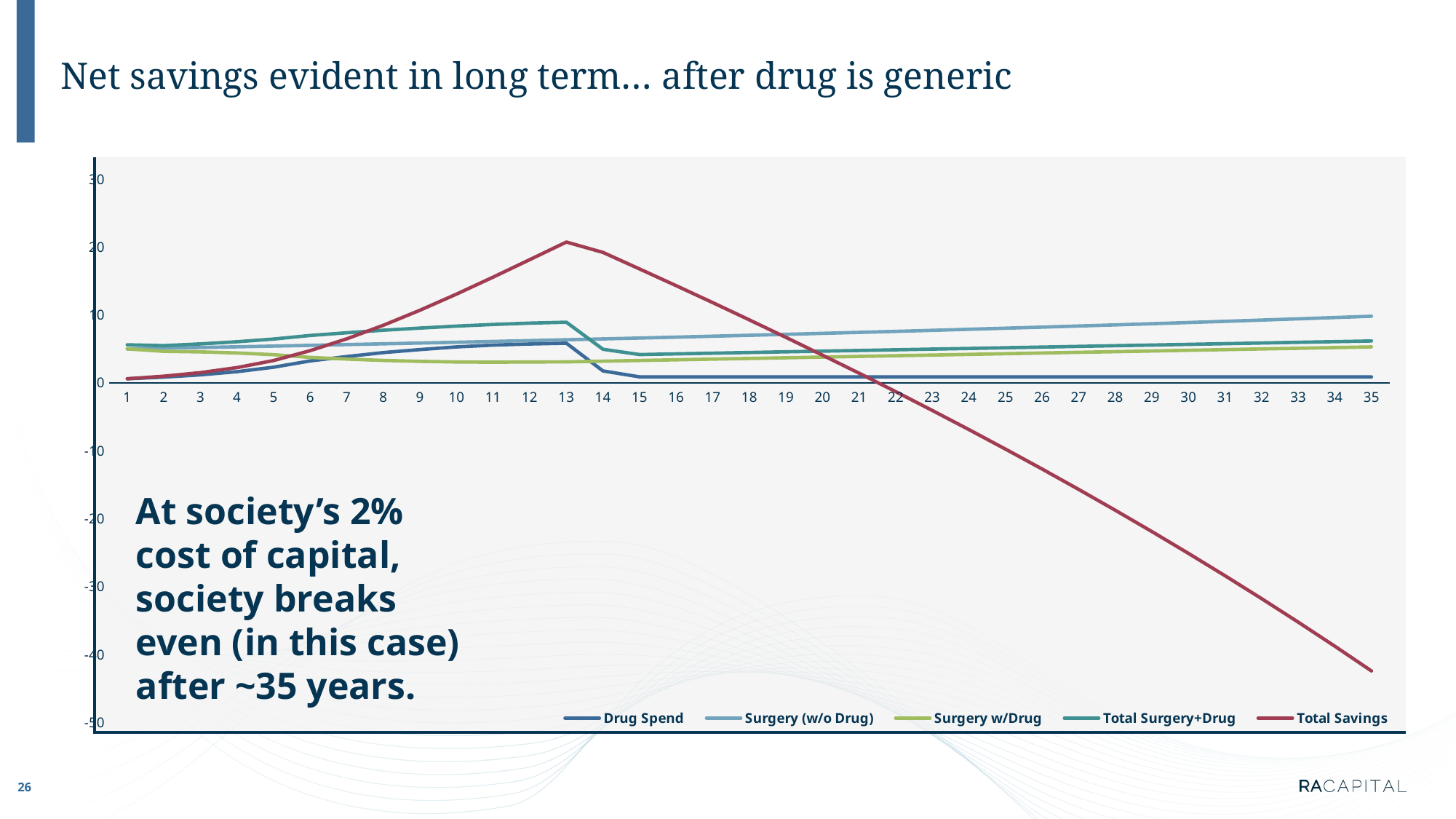
Which series has the highest value at x = 35? Surgery (w/o Drug) Is the value of Total Savings at x = 35 greater or less than -30? less Does the Drug Spend line rise or fall from x = 1 to x = 13? rise How many series does the legend list? 5 What kind of chart is shown on the slide? line chart Is the value of Total Savings at x = 13 greater or less than 10? greater Which series reaches the highest value anywhere on the chart? Total Savings At x = 35, which is larger: Drug Spend or Surgery w/Drug? Surgery w/Drug Does the Total Savings line rise or fall from x = 13 to x = 35? fall What colour is the Total Savings line? red How many points are labelled along the x axis? 35 Which series has the lowest value at x = 35? Total Savings